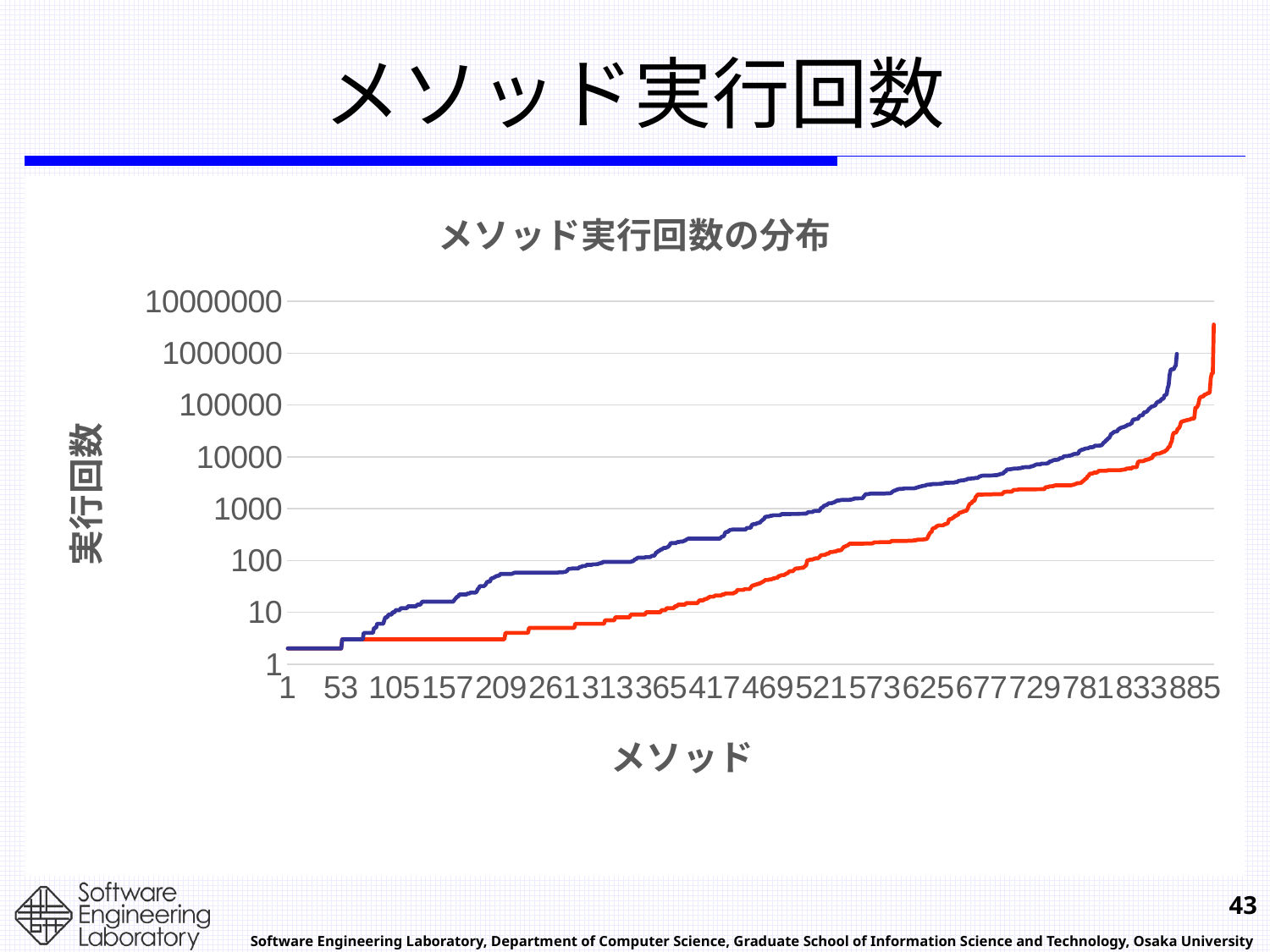
Do the values of the red line rise or fall as you move from left to right along the x axis? rise Is the value of the blue line at method 625 greater or less than 1000? greater Do the values of the blue line rise or fall as you move from left to right along the x axis? rise Is the value of the blue line at method 417 greater or less than 100? greater What is the title of the chart? メソッド実行回数の分布 At method 417, which line has the higher value, the blue line or the red line? the blue line What kind of chart is shown on the slide? line chart Is the value of the red line at method 417 greater or less than 100? less What is the label of the vertical axis of the chart? 実行回数 At the right end of the chart (around method 885), which line reaches the higher value, the blue line or the red line? the red line